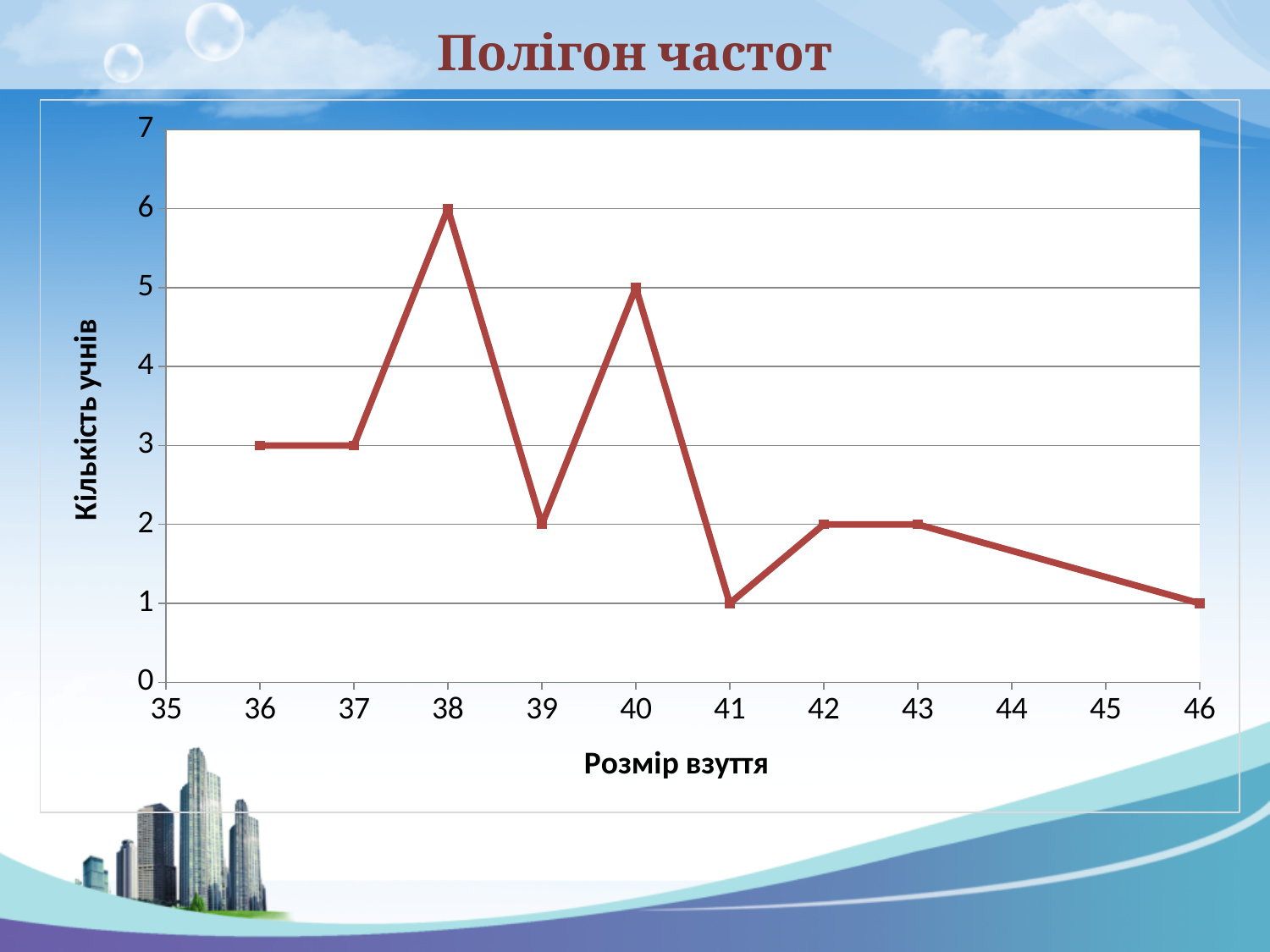
What is the difference between the number of students for shoe size 38 and shoe size 39? 4 How many data points are plotted on the line? 9 What is the number of students for shoe size 36? 3 Which has more students: shoe size 40 or shoe size 42? shoe size 40 Is the value for shoe size 38 greater or less than 5? greater What kind of chart is shown on the slide? line chart Which shoe size has the highest number of students? 38 What is the label of the horizontal axis? Розмір взуття What is the title of the chart? Полігон частот What is the number of students for shoe size 40? 5 What is the number of students for shoe size 41? 1 What is the number of students (Кількість учнів) for shoe size 38? 6